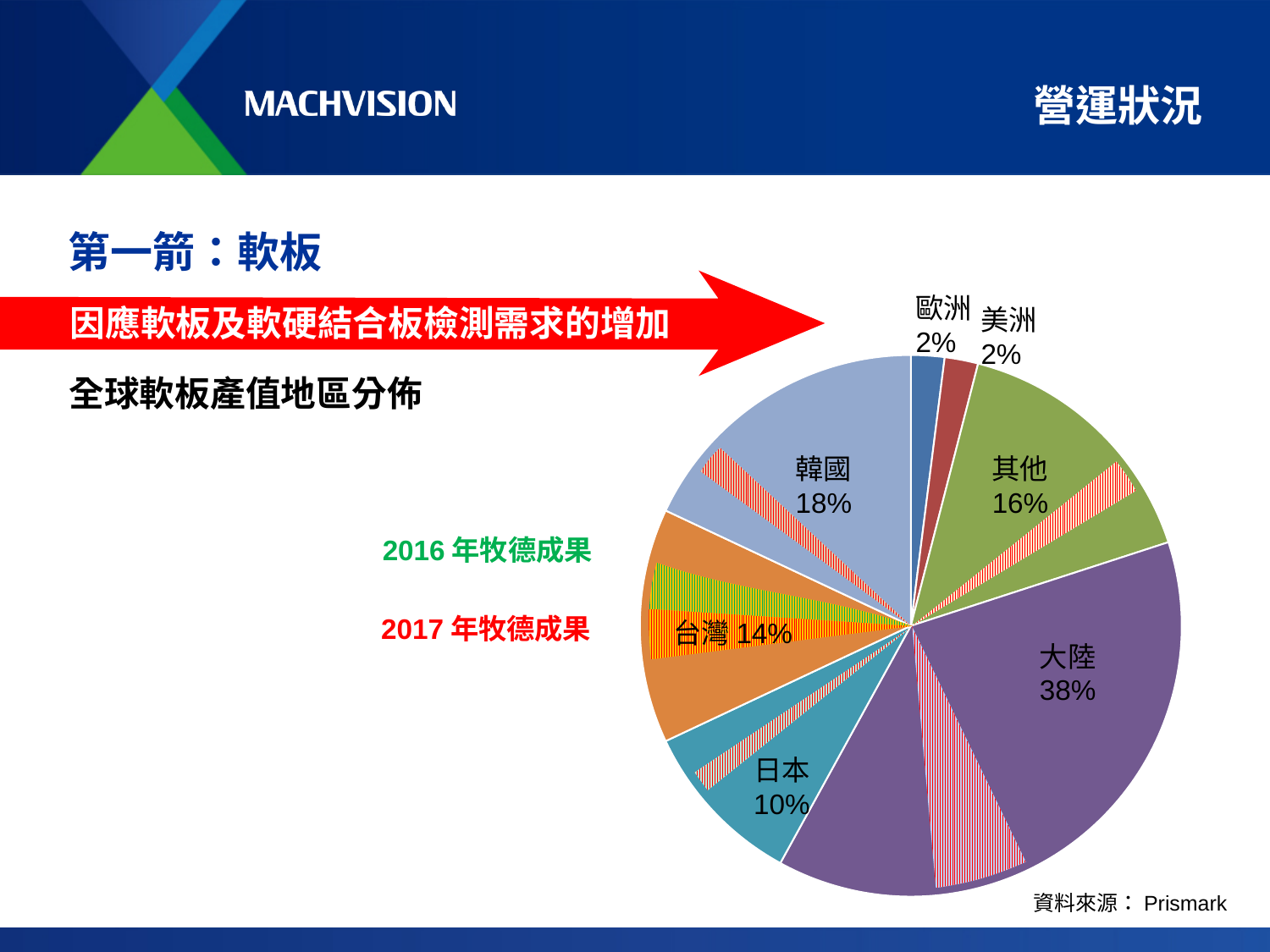
What is the value shown for 台灣? 14% Which region has the largest slice of the pie? 大陸 What is the difference between the shares of 台灣 and 日本? 4% What is the difference between the shares of 大陸 and 韓國? 20% What kind of chart is shown on the slide? pie chart What is the value shown for 其他? 16% What is the value shown for 日本? 10% How many slices does the pie chart have? 7 What is the value shown for 韓國? 18% What is the title of the pie chart on the slide? 全球軟板產值地區分佈 What share of the pie does 大陸 hold? 38% Which is larger, the share of 其他 or the share of 台灣? 其他